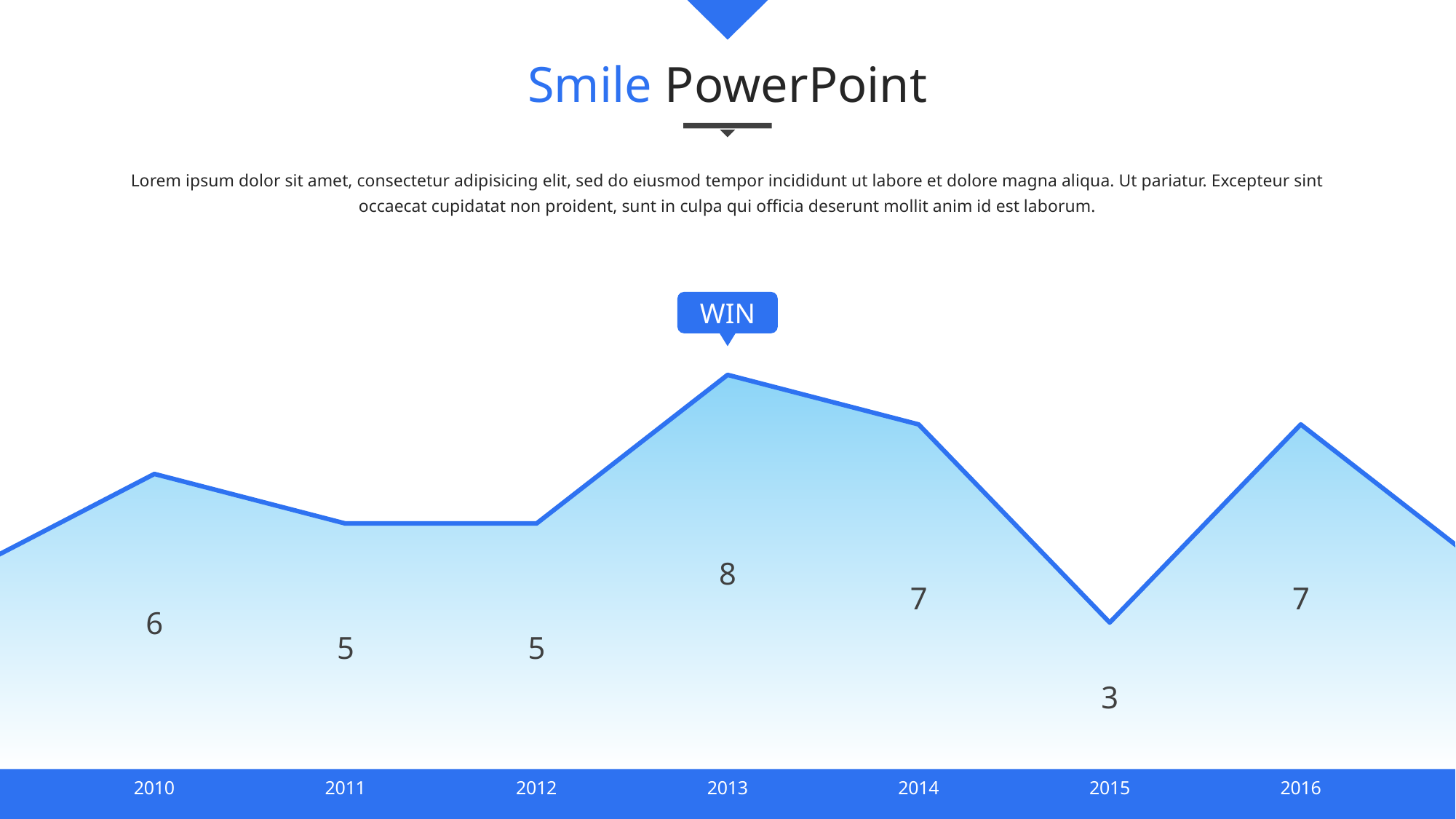
Which year has the lowest value? 2015 What is the difference between the values for 2013 and 2015? 5 What is the value for 2015? 3 How many years are shown on the x axis? 7 Which year has the highest value? 2013 What is the value for 2010? 6 Do the values rise or fall from 2013 to 2015? fall What is the value for 2013? 8 Which year is marked with the "WIN" label? 2013 What kind of chart is shown on the slide? area chart Which is larger, the value for 2010 or the value for 2011? 2010 What is the value for 2016? 7